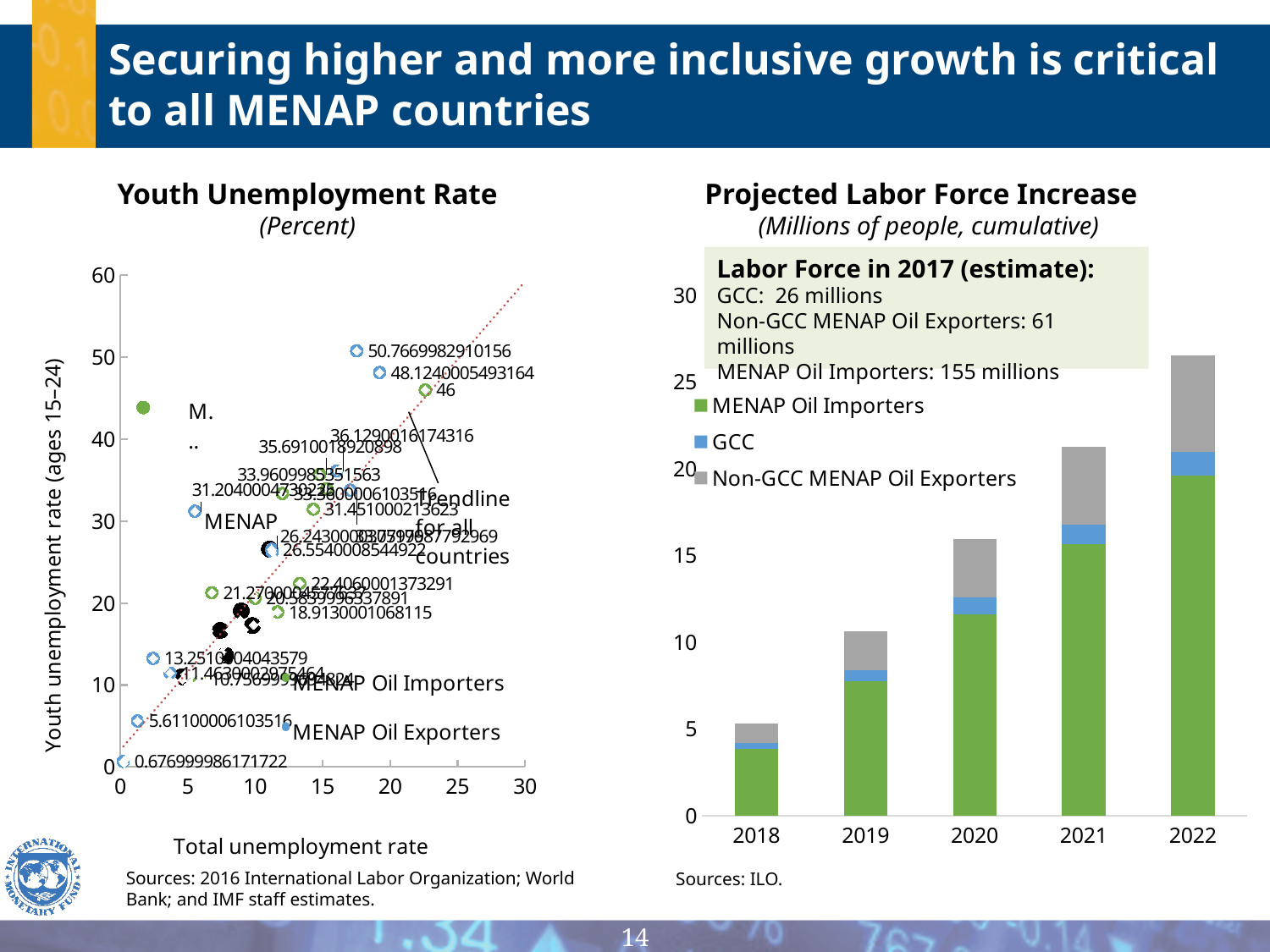
On the Projected Labor Force Increase chart, how many years are shown on the x axis? 5 On the Projected Labor Force Increase chart, do the stacked bar totals rise or fall from 2018 to 2022? Rise On the Youth Unemployment Rate chart, what kind of chart is shown? Scatter chart On the Projected Labor Force Increase chart, which year has the shortest stacked bar? 2018 On the Projected Labor Force Increase chart, which year has the tallest stacked bar? 2022 On the Projected Labor Force Increase chart, what kind of chart is shown? Stacked bar chart On the Youth Unemployment Rate chart, what is the highest youth unemployment rate value labeled on the chart? 50.7669982910156 On the Projected Labor Force Increase chart, how many series does the legend list? 3 On the Youth Unemployment Rate chart, what is the label of the x axis? Total unemployment rate On the Projected Labor Force Increase chart, is the total stacked bar for 2020 greater or less than 15? greater On the Projected Labor Force Increase chart, which series is shown in green? MENAP Oil Importers On the Projected Labor Force Increase chart, is the total stacked bar for 2022 greater or less than 25? greater